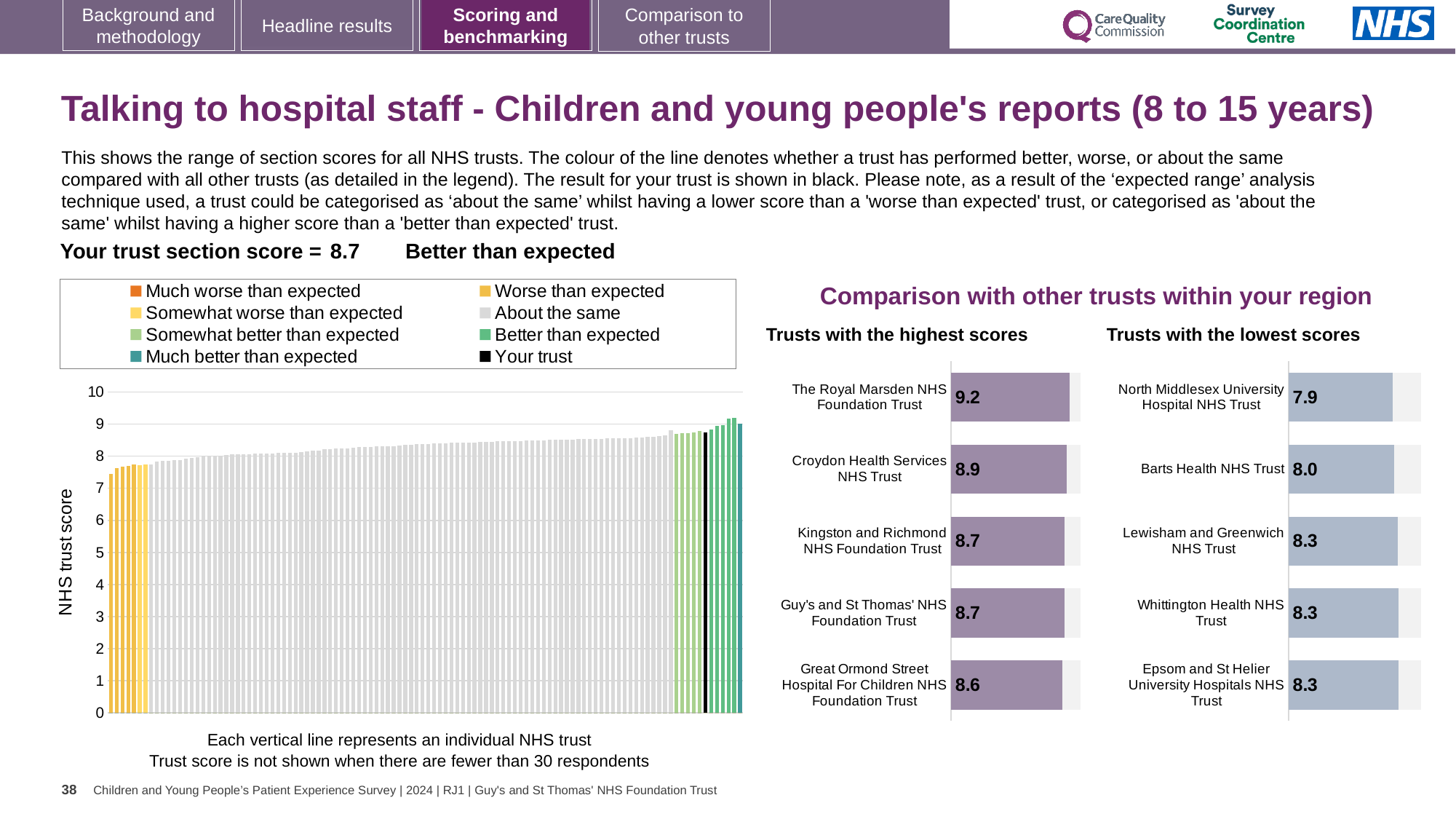
In the 'Trusts with the highest scores' chart, what is the score for The Royal Marsden NHS Foundation Trust? 9.2 In the large chart on the left, do the trust scores rise or fall from left to right? Rise In the 'Trusts with the lowest scores' chart, which trust has the lowest score? North Middlesex University Hospital NHS Trust How many trusts are listed in the 'Trusts with the lowest scores' chart? 5 In the 'Trusts with the highest scores' chart, what is the difference between the scores of The Royal Marsden NHS Foundation Trust and Great Ormond Street Hospital For Children NHS Foundation Trust? 0.6 In the 'Trusts with the highest scores' chart, which trust has the highest score? The Royal Marsden NHS Foundation Trust In the large chart on the left, is the value of the black bar (your trust) greater or less than 8? greater Which is larger: the score for Croydon Health Services NHS Trust in the highest scores chart or the score for Barts Health NHS Trust in the lowest scores chart? Croydon Health Services NHS Trust In the 'Trusts with the highest scores' chart, what is the score for Great Ormond Street Hospital For Children NHS Foundation Trust? 8.6 In the 'Trusts with the lowest scores' chart, what is the difference between the scores of Barts Health NHS Trust and North Middlesex University Hospital NHS Trust? 0.1 In the 'Trusts with the lowest scores' chart, what is the score for North Middlesex University Hospital NHS Trust? 7.9 What kind of chart is the large chart on the left showing NHS trust scores? Bar chart